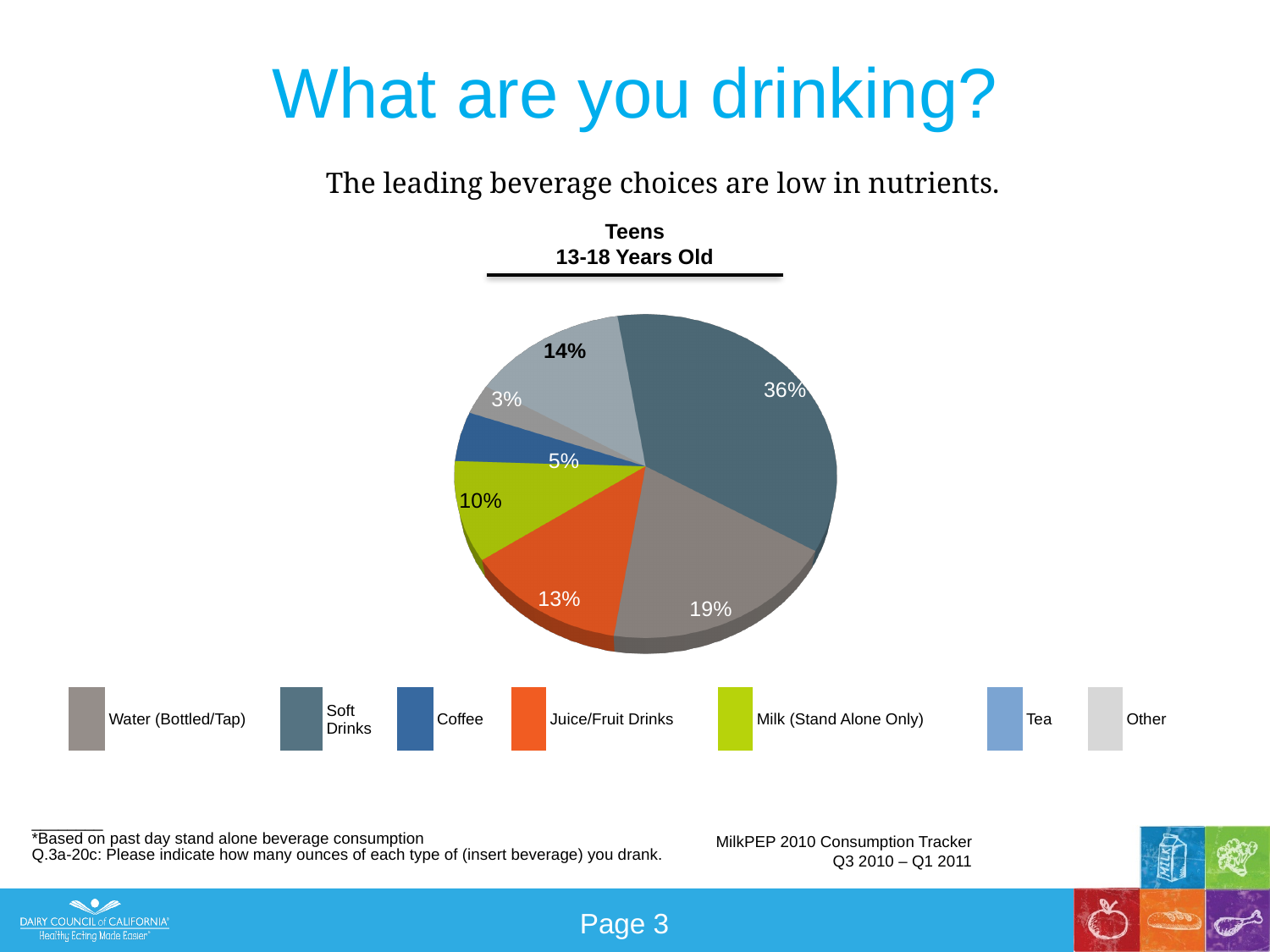
Which beverage has the largest slice of the pie? Soft Drinks Which beverage has the smallest slice of the pie? Other What share of the pie is Soft Drinks? 36% What share of the pie is Juice/Fruit Drinks? 13% Which is larger, the share for Tea or the share for Juice/Fruit Drinks? Tea What type of chart is shown on the slide? pie chart What share of the pie is Milk (Stand Alone Only)? 10% What share of the pie is Water (Bottled/Tap)? 19% How many beverage categories does the legend list? 7 What is the difference in percentage points between Soft Drinks and Water (Bottled/Tap)? 17 What share of the pie is Tea? 14% What share of the pie is Coffee? 5%